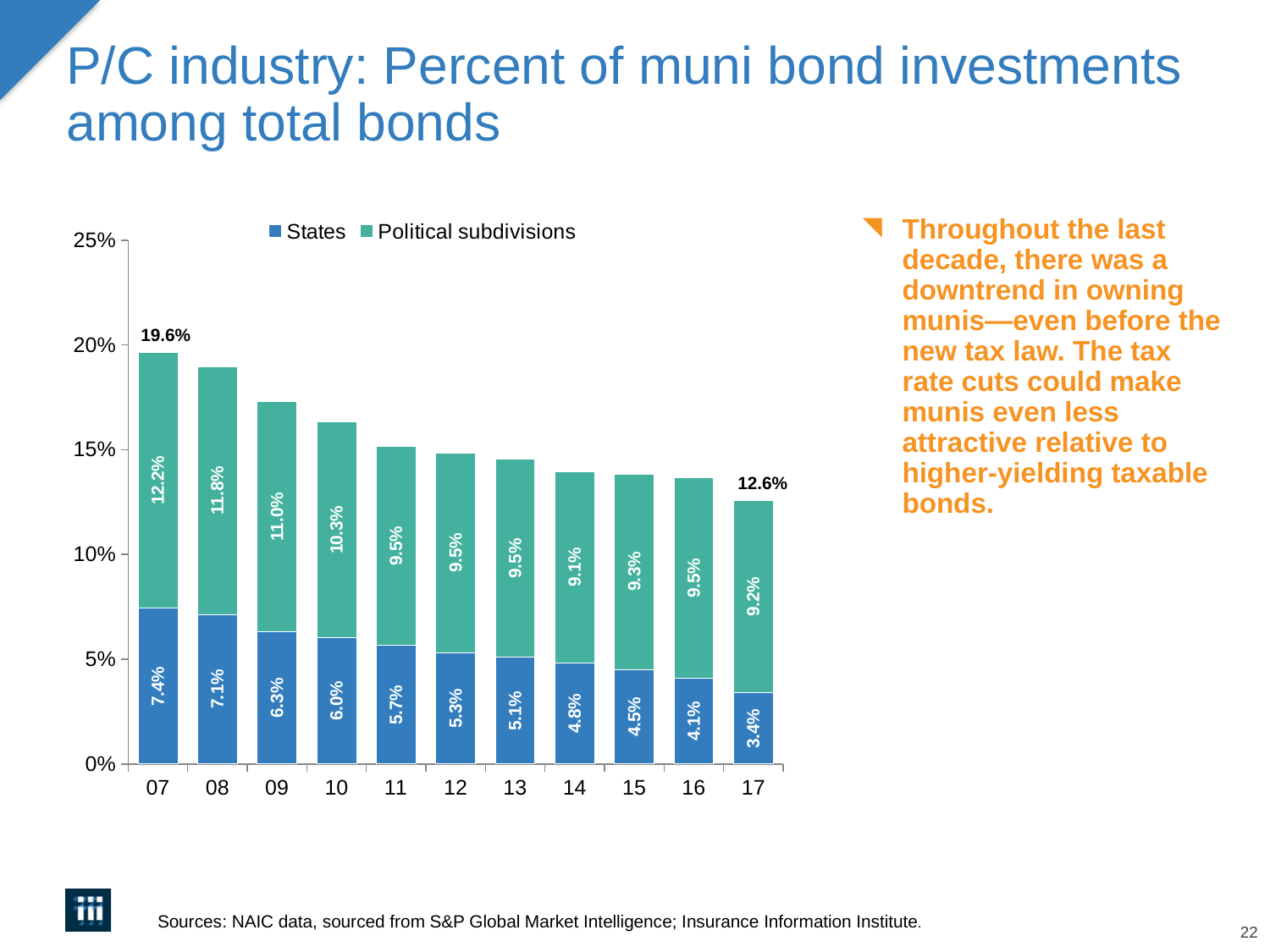
What is the total of the stacked bar for 07? 19.6% What is the States value for 12? 5.3% Which year has the highest States value? 07 Do the States values rise or fall from 07 to 17? Fall Which is larger, the States value for 10 or for 11? 10 How many years are shown on the x axis? 11 Is the total stacked bar for 10 greater or less than 15%? greater How many series does the legend list? 2 What kind of chart is shown? Stacked bar chart What is the difference between the States value for 07 and for 17? 4.0 percentage points What is the Political subdivisions value for 09? 11.0% Which year has the lowest Political subdivisions value? 14